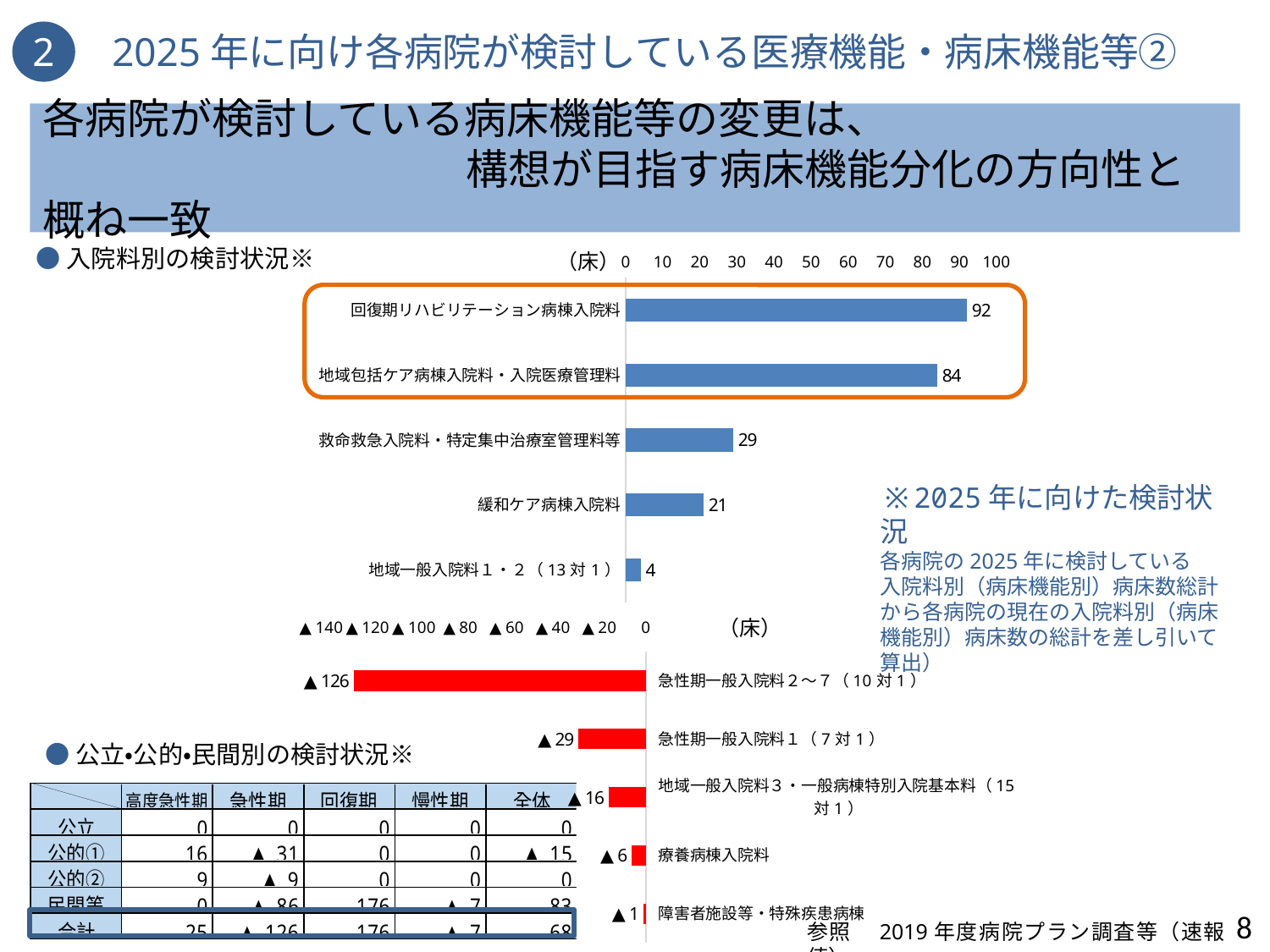
In the upper bar chart (blue bars), which category has the highest value? 回復期リハビリテーション病棟入院料 What type of chart is the upper chart with blue bars? Bar chart In the lower bar chart (red bars), what is the difference between the values for 急性期一般入院料１（７対１） and 地域一般入院料３・一般病棟特別入院基本料（15対１）? 13 In the upper bar chart (blue bars), how many categories are plotted? 5 In the upper bar chart (blue bars), what is the value for 地域包括ケア病棟入院料・入院医療管理料? 84 In the upper bar chart (blue bars), what is the difference between the values for 救命救急入院料・特定集中治療室管理料等 and 緩和ケア病棟入院料? 8 In the lower bar chart (red bars), what is the value for 急性期一般入院料２～７（10対１）? ▲126 In the lower bar chart (red bars), which category has the largest decrease? 急性期一般入院料２～７（10対１） In the upper bar chart (blue bars), which category has the lowest value? 地域一般入院料１・２（13対１） In the upper bar chart (blue bars), what is the value for 回復期リハビリテーション病棟入院料? 92 In the lower bar chart (red bars), how many categories are plotted? 5 In the lower bar chart (red bars), what is the value for 療養病棟入院料? ▲6